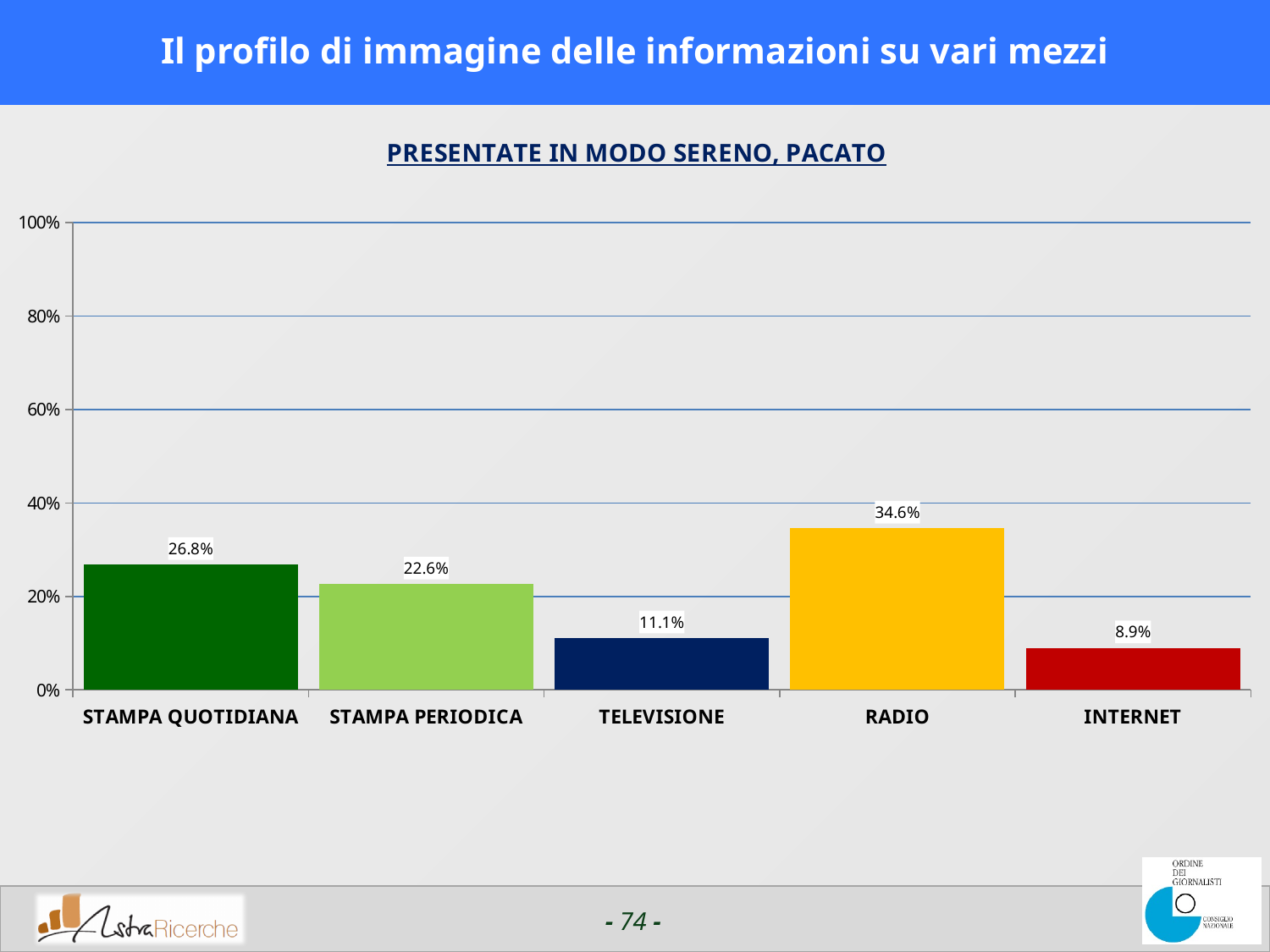
Which category has the lowest value? INTERNET What is the difference between the values for STAMPA QUOTIDIANA and STAMPA PERIODICA? 4.2% What is the value for STAMPA QUOTIDIANA? 26.8% What kind of chart is shown on the slide? bar chart What is the title of the chart? PRESENTATE IN MODO SERENO, PACATO Is the value for RADIO greater or less than 40%? less What is the value for RADIO? 34.6% How many categories are shown on the x axis? 5 What is the value for INTERNET? 8.9% Which category has the highest value? RADIO What is the difference between the values for RADIO and TELEVISIONE? 23.5% Which is larger, the value for STAMPA PERIODICA or the value for TELEVISIONE? STAMPA PERIODICA